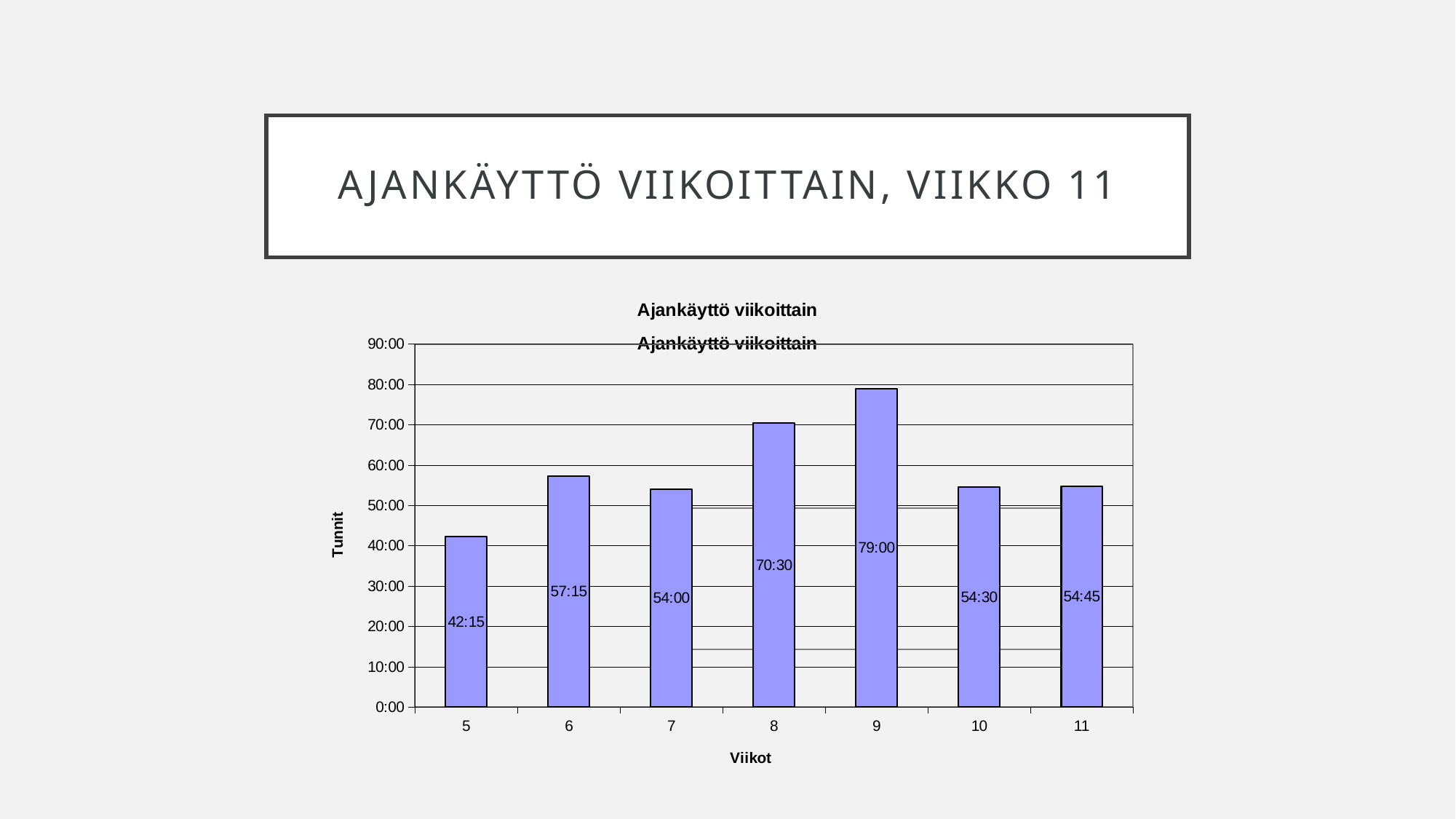
What is the value for week 9? 79:00 Which week has the highest value? 9 Which is larger, the value for week 6 or the value for week 7? week 6 What is the label of the y axis? Tunnit What is the value for week 11? 54:45 What is the difference between the values for week 9 and week 8? 8:30 What is the title of the chart? Ajankäyttö viikoittain Is the value for week 8 greater or less than 60:00? greater How many weeks are shown on the x axis? 7 What kind of chart is shown on the slide? bar chart Which week has the lowest value? 5 What is the value for week 5? 42:15